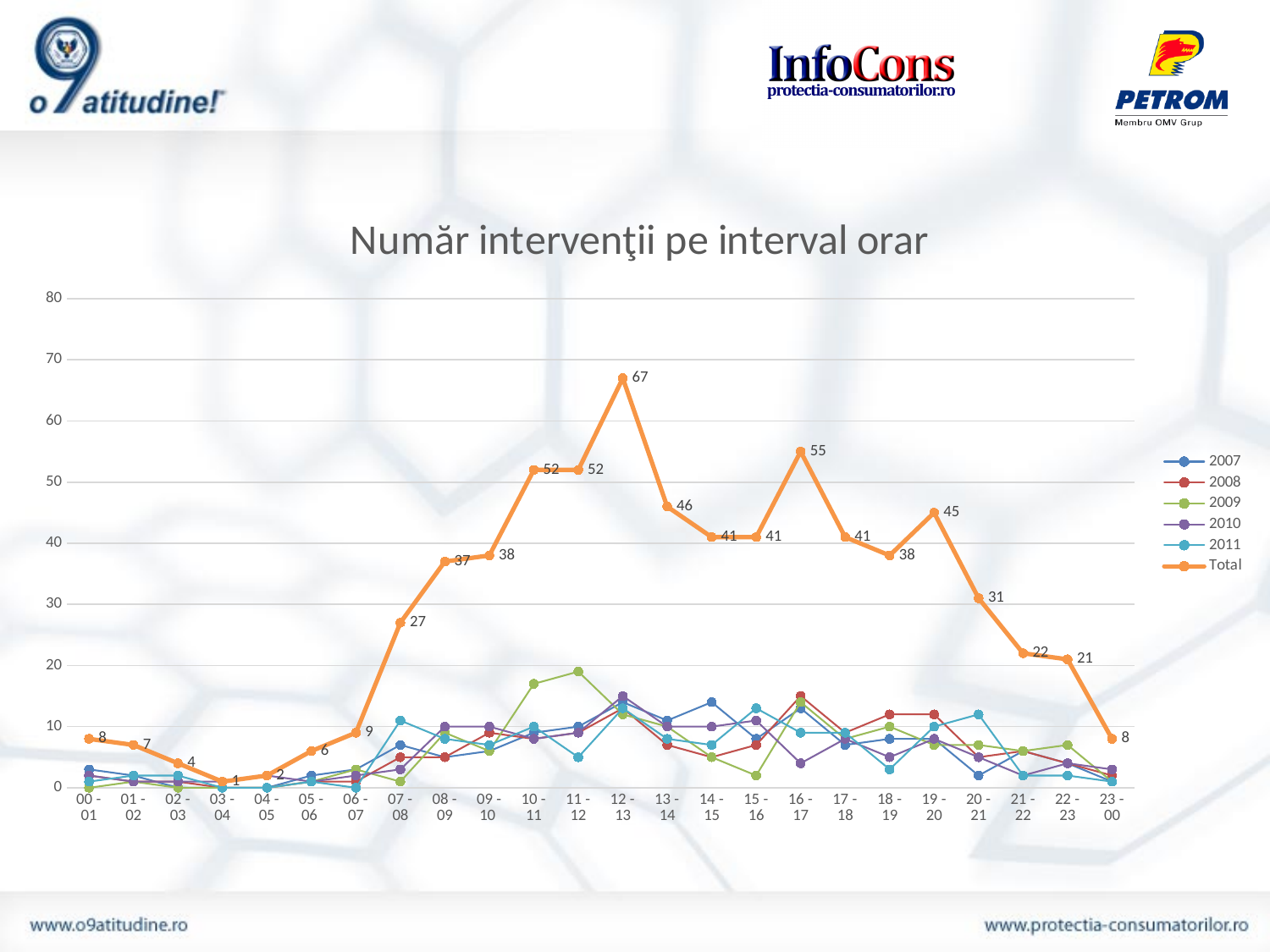
How many series does the legend list? 6 In which hourly interval is the Total lowest? 03 - 04 In which hourly interval is the Total highest? 12 - 13 What is the Total value for the interval 16 - 17? 55 What is the Total value for the interval 12 - 13? 67 What is the difference between the Total for 12 - 13 and the Total for 13 - 14? 21 Which is larger, the Total for 19 - 20 or the Total for 20 - 21? 19 - 20 Does the Total rise or fall from the interval 20 - 21 to the interval 23 - 00? fall What kind of chart is shown on the slide? line chart Which series is drawn with the thick orange line? Total How many hourly intervals are shown on the x axis? 24 What is the title of the chart? Număr intervenţii pe interval orar